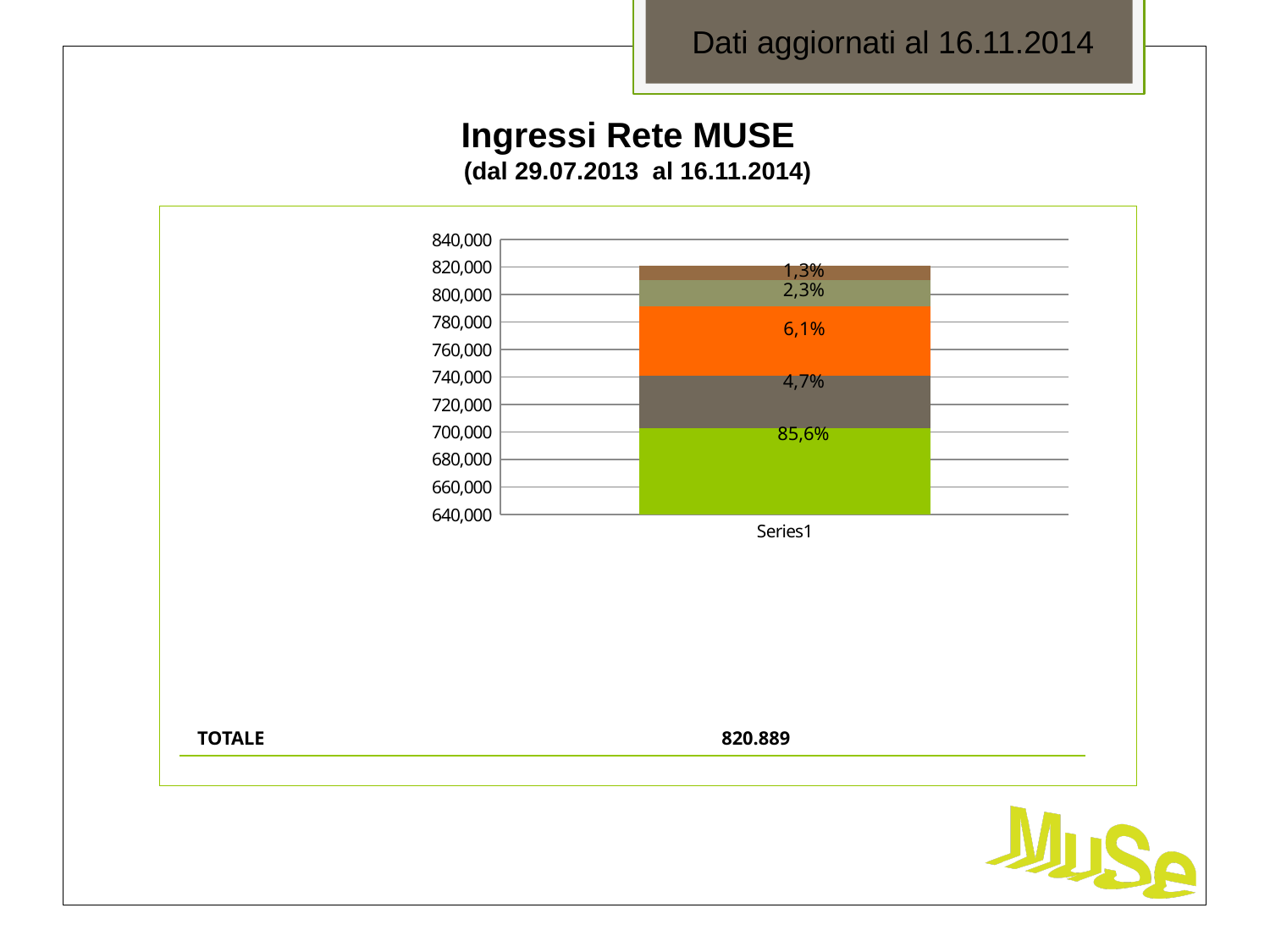
What is the difference between the 6,1% segment and the 4,7% segment? 1,4% What percentage label is printed on the orange segment of the bar? 6,1% What percentage label is printed on the green segment at the bottom of the bar? 85,6% What is the category label shown on the x axis of the chart? Series1 What kind of chart is shown on the slide? bar chart Is the top of the stacked bar greater or less than 800,000 on the y axis? greater What is the largest percentage label shown on the stacked bar? 85,6% How many segments make up the stacked bar? 5 What is the smallest percentage label shown on the stacked bar? 1,3% What is the highest value shown on the y axis of the chart? 840,000 What percentage label is printed on the topmost segment of the bar? 1,3% How many bars does the chart contain? 1